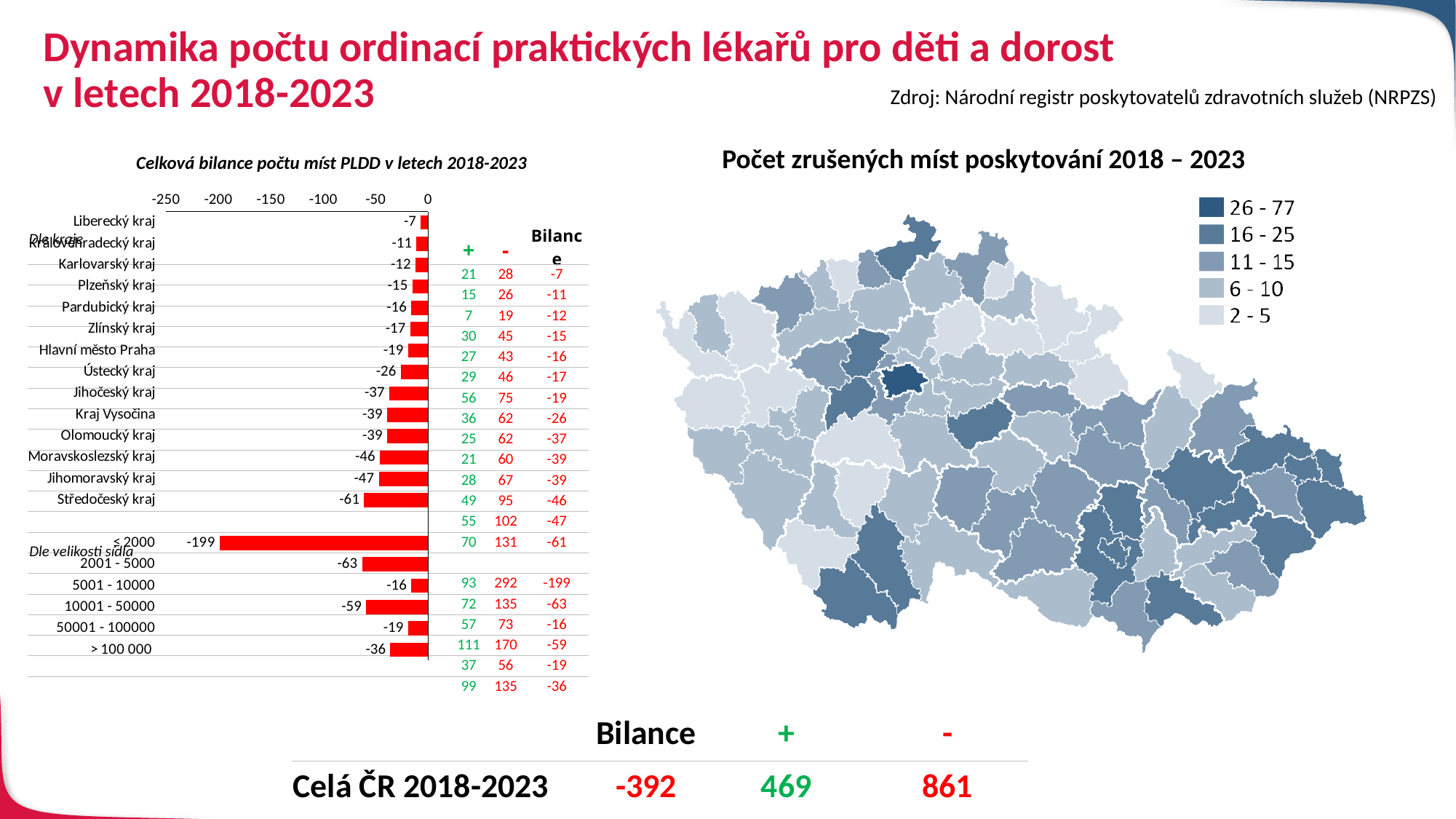
In the chart 'Celková bilance počtu míst PLDD v letech 2018-2023', what is the value for Středočeský kraj? -61 How many value ranges does the legend of the map 'Počet zrušených míst poskytování 2018 – 2023' list? 5 In the chart 'Celková bilance počtu míst PLDD v letech 2018-2023', which region has the most negative balance? Středočeský kraj In the chart 'Celková bilance počtu míst PLDD v letech 2018-2023', what is the difference between the values for Jihomoravský kraj and Ústecký kraj? 21 What type of chart is 'Celková bilance počtu míst PLDD v letech 2018-2023'? Bar chart How many settlement size categories are shown in the chart 'Celková bilance počtu míst PLDD v letech 2018-2023'? 6 How many regions (kraje) are listed in the chart 'Celková bilance počtu míst PLDD v letech 2018-2023'? 14 In the chart 'Celková bilance počtu míst PLDD v letech 2018-2023', what is the value for the '< 2000' settlement size category? -199 In the chart 'Celková bilance počtu míst PLDD v letech 2018-2023', is the value for '< 2000' greater or less than -150? less In the chart 'Celková bilance počtu míst PLDD v letech 2018-2023', what is the value for Hlavní město Praha? -19 In the chart 'Celková bilance počtu míst PLDD v letech 2018-2023', which region has the smallest negative balance (closest to zero)? Liberecký kraj In the chart 'Celková bilance počtu míst PLDD v letech 2018-2023', which has the more negative value: '2001 - 5000' or '10001 - 50000'? 2001 - 5000